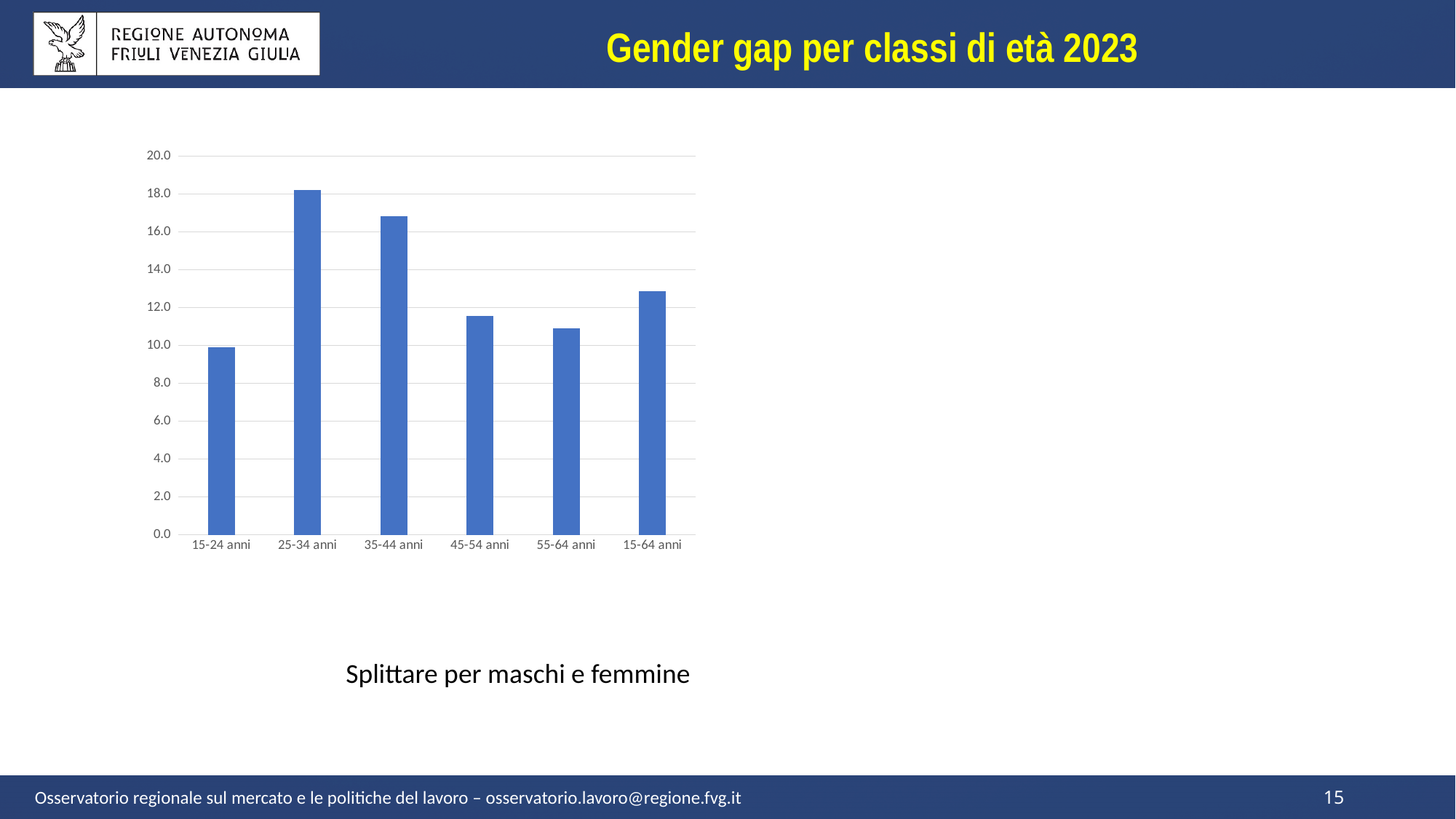
Is the value for 15-24 anni greater or less than 12.0? less Which age class has the lowest value in the chart? 15-24 anni Is the value for 55-64 anni greater or less than 12.0? less How many age-class categories are shown on the x axis of the chart? 6 Is the value for 35-44 anni greater or less than 14.0? greater Which age class has the highest value in the chart? 25-34 anni Which has the larger value, 35-44 anni or 45-54 anni? 35-44 anni What is the title of the slide containing the chart? Gender gap per classi di età 2023 What kind of chart is shown on the slide? bar chart Which has the larger value, 15-64 anni or 55-64 anni? 15-64 anni